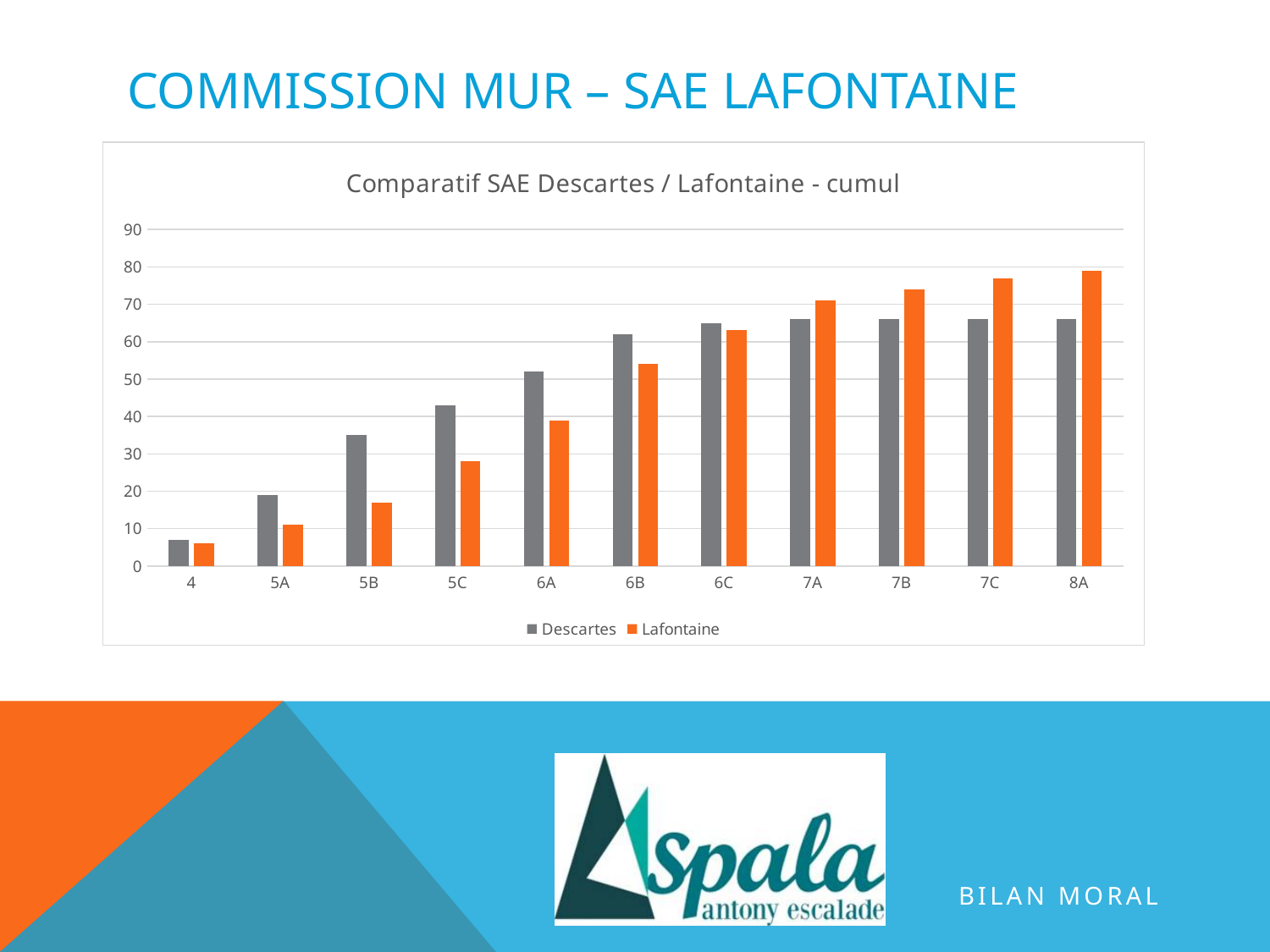
What kind of chart is shown on the slide? bar chart Which category has the lowest value for Descartes? 4 Is the value for Lafontaine at 5A greater or less than 20? less How many categories are shown on the x axis? 11 At 8A, which series has the larger value, Descartes or Lafontaine? Lafontaine Do the Lafontaine values rise or fall from 4 to 8A along the x axis? rise Which category has the highest value for Lafontaine? 8A At 5B, which series has the larger value, Descartes or Lafontaine? Descartes How many series does the legend list? 2 Is the value for Lafontaine at 8A greater or less than 70? greater What is the title of the chart? Comparatif SAE Descartes / Lafontaine - cumul Is the value for Descartes at 5B greater or less than 30? greater